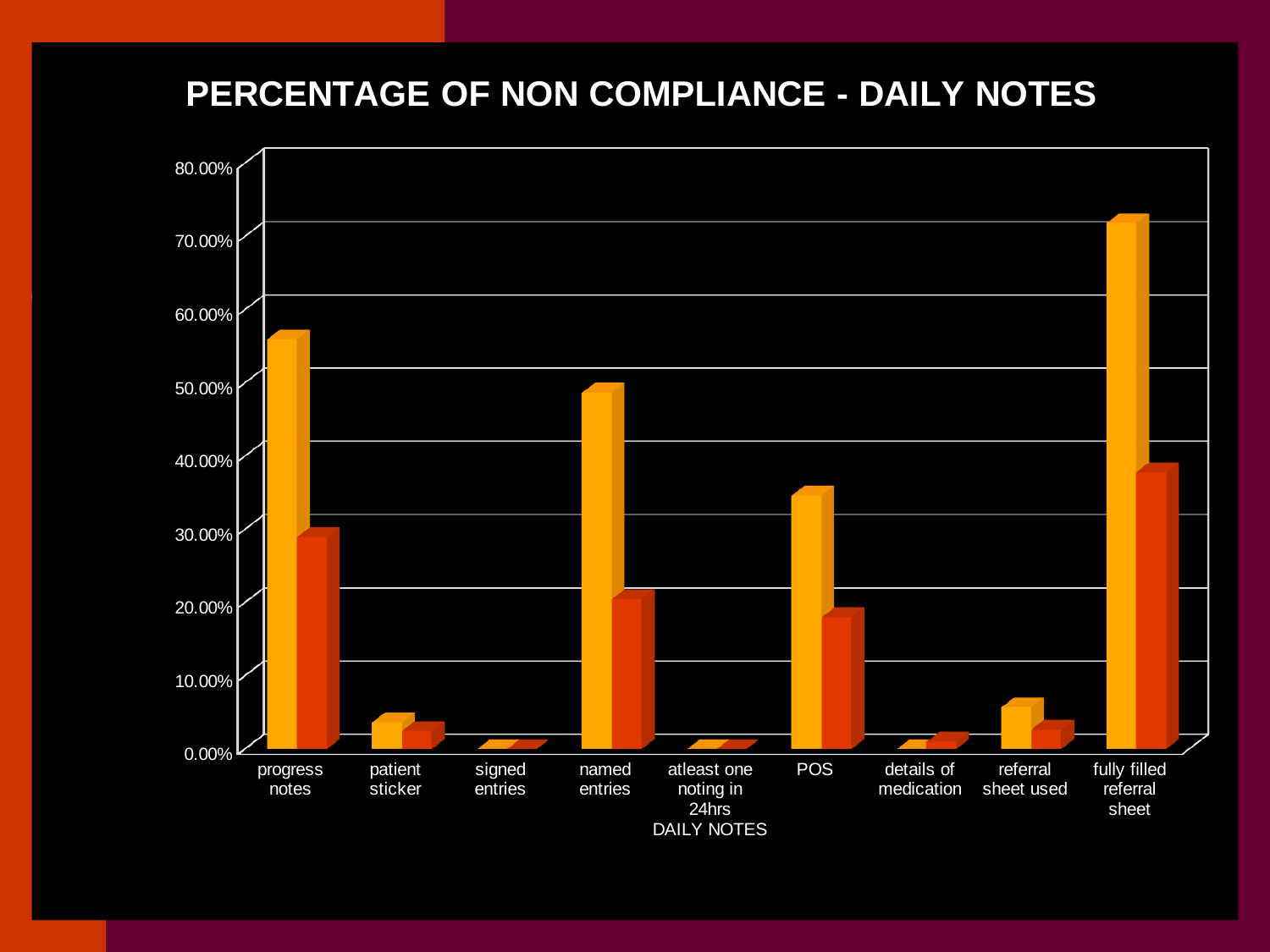
Is the orange bar for POS greater or less than 10.00%? greater How many categories are shown along the x axis? 9 Is the yellow bar for progress notes greater or less than 50.00%? greater Is the yellow bar for patient sticker greater or less than 10.00%? less For fully filled referral sheet, which bar is taller, the yellow one or the orange one? the yellow one What kind of chart is shown on the slide? bar chart What is the label of the x axis? DAILY NOTES Which category has the tallest yellow bar? fully filled referral sheet Which has the taller yellow bar, progress notes or named entries? progress notes Which category has the tallest orange bar? fully filled referral sheet What is the title of the chart? PERCENTAGE OF NON COMPLIANCE - DAILY NOTES